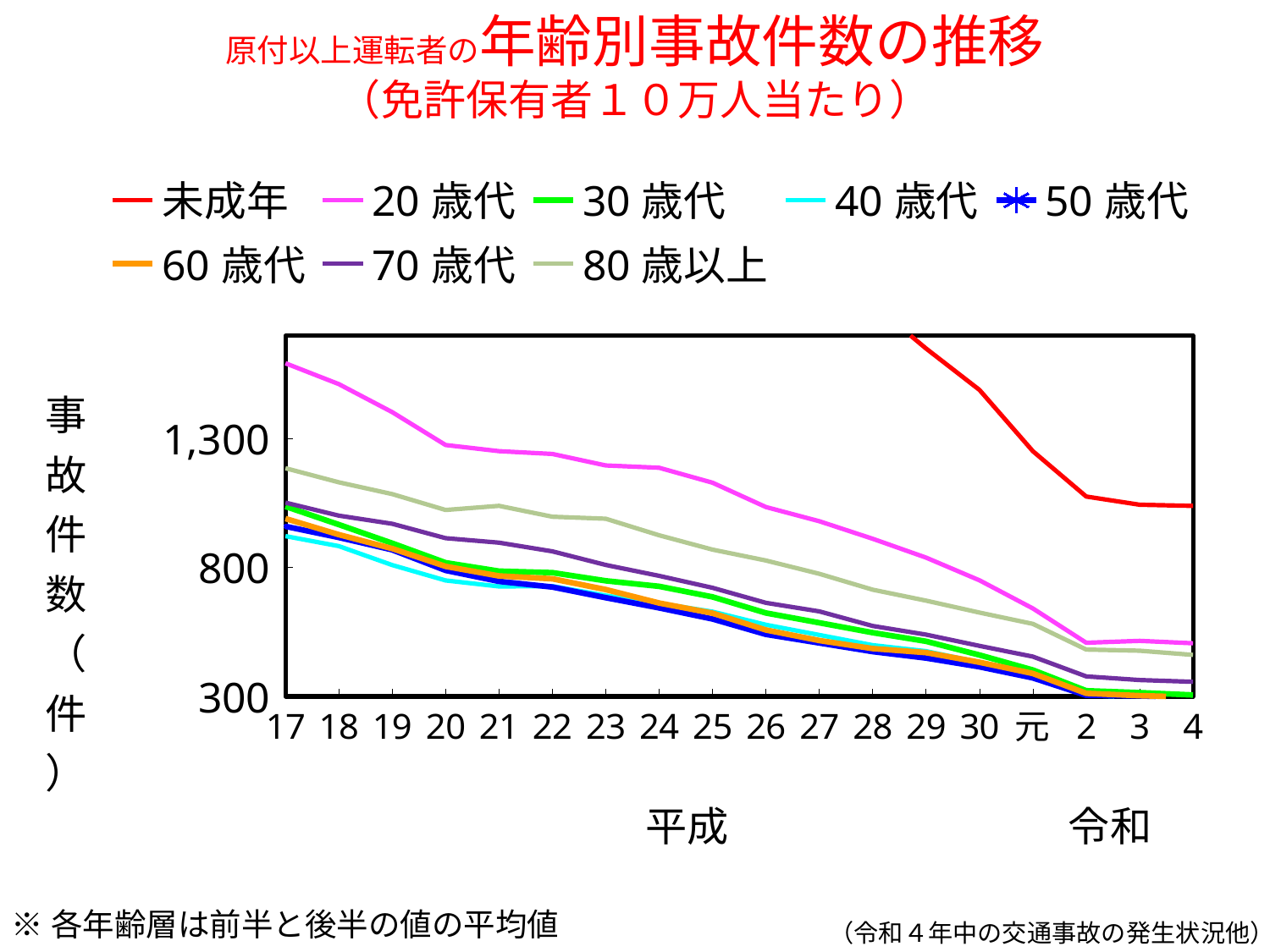
Is the value for 80歳以上 at 17 greater or less than 800? greater At 17, which is larger: 20歳代 or 80歳以上? 20歳代 What kind of chart is shown on the slide? line chart Do the values for 20歳代 rise or fall from 17 to 4 along the x axis? fall Is the value for 20歳代 at 4 greater or less than 800? less Is the value for 20歳代 at 17 greater or less than 1,300? greater Which series has the highest value at 4? 未成年 What is the label on the y axis of the chart? 事故件数（件） How many points are on the x axis of the chart? 18 How many series does the legend list? 8